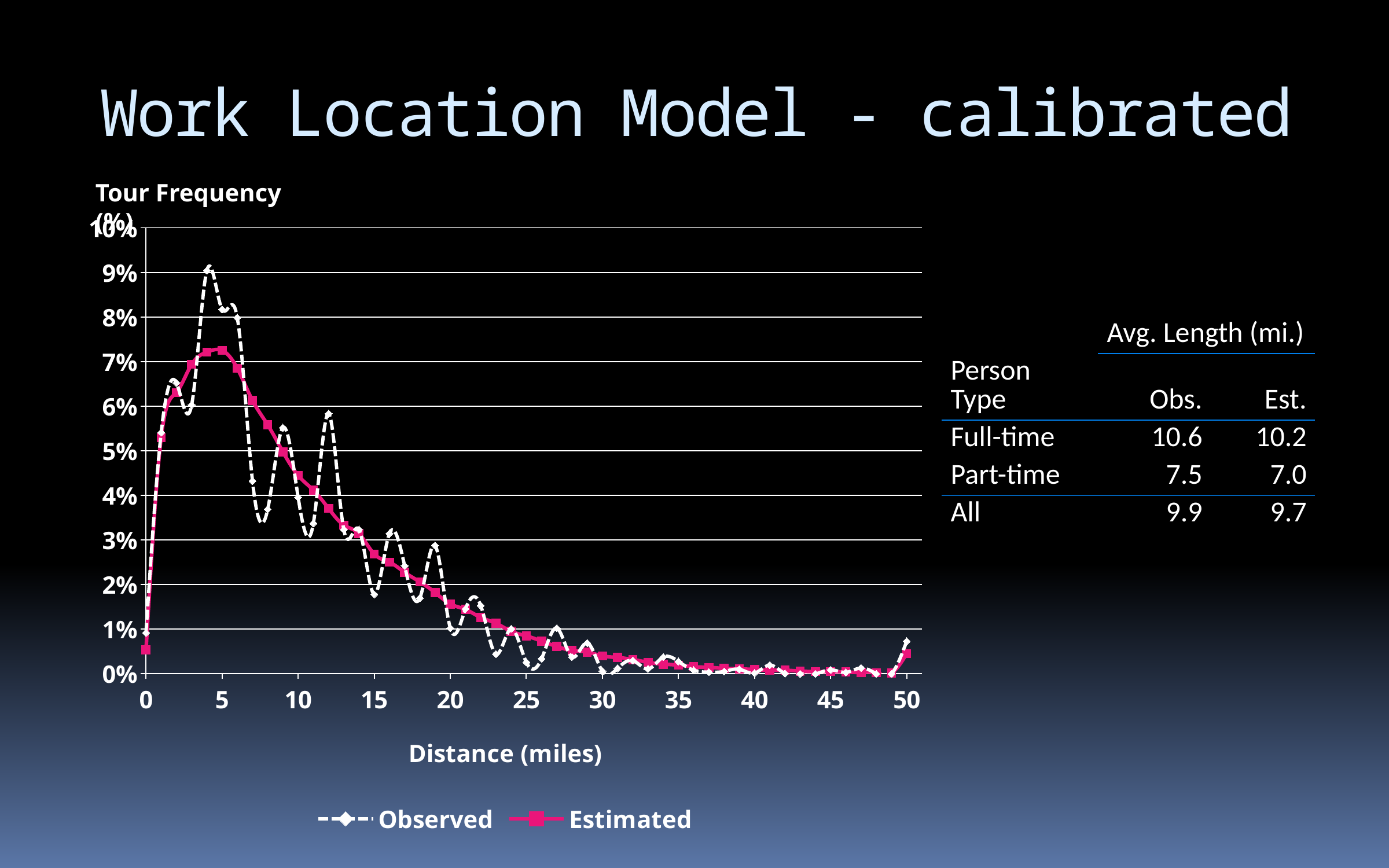
What is the title of the chart's x axis? Distance (miles) Is the Observed value at 12 miles greater or less than 5%? greater Is the peak value of the Observed series greater or less than 8%? greater At 4 miles, which series has the higher tour frequency, Observed or Estimated? Observed Does the Estimated series rise or fall as distance increases from 5 miles to 45 miles? fall At 7 miles, which series has the higher tour frequency, Observed or Estimated? Estimated How many series does the chart's legend list? 2 What kind of chart is shown on the slide? line chart What are the two series named in the chart's legend? Observed and Estimated Is the Estimated value at 20 miles greater or less than 2%? less